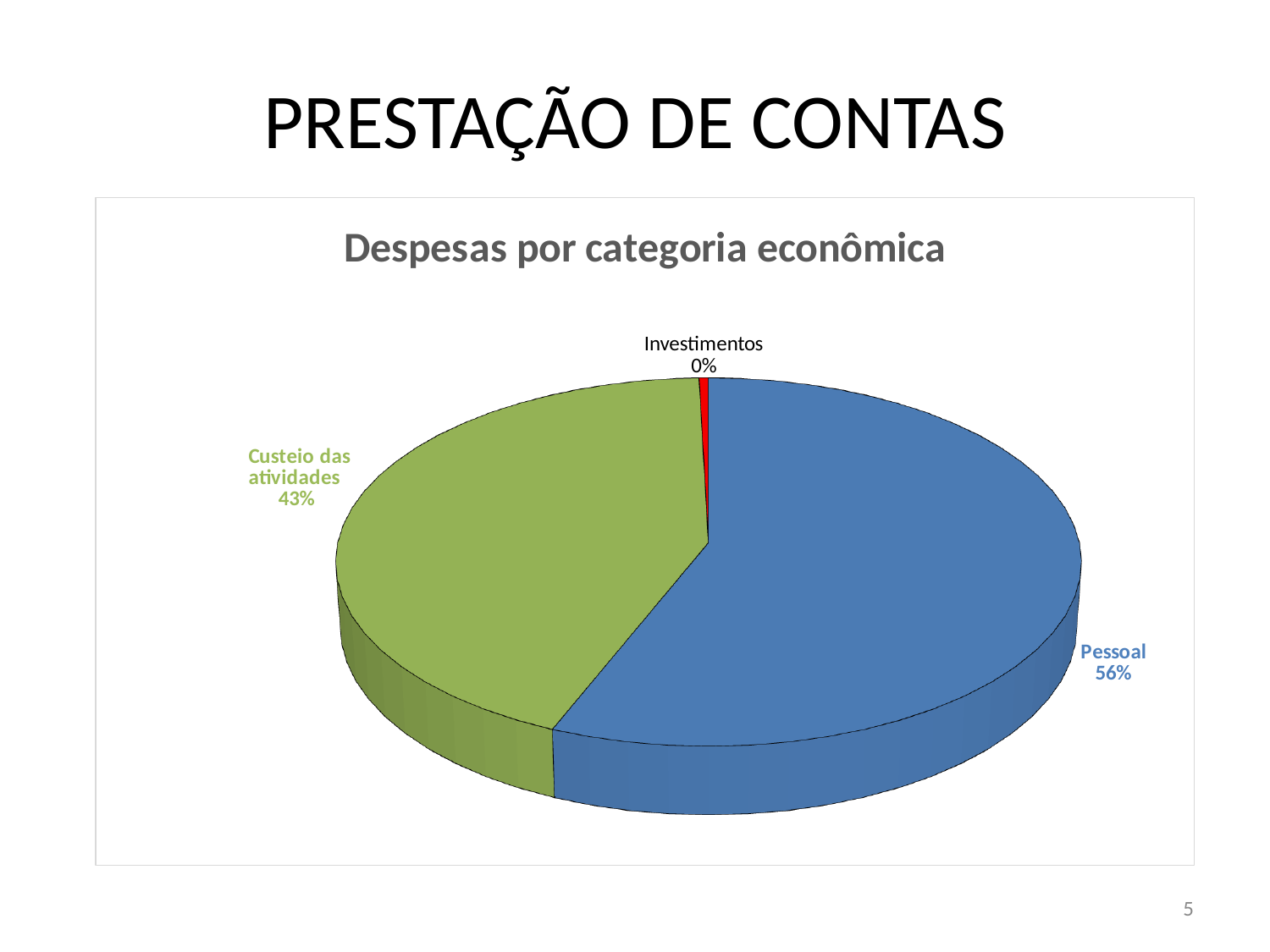
What type of chart is shown on the slide? Pie chart What is the title of the chart? Despesas por categoria econômica What percentage of expenses is shown for Custeio das atividades? 43% What percentage of expenses is shown for Investimentos? 0% Which category has the smallest share of expenses? Investimentos What colour is the slice for Custeio das atividades? Green What percentage of expenses is shown for Pessoal? 56% Which category has the largest share of expenses? Pessoal Which is larger, the share for Pessoal or the share for Custeio das atividades? Pessoal What is the difference in percentage points between Pessoal and Custeio das atividades? 13 How many categories are shown in the pie chart? 3